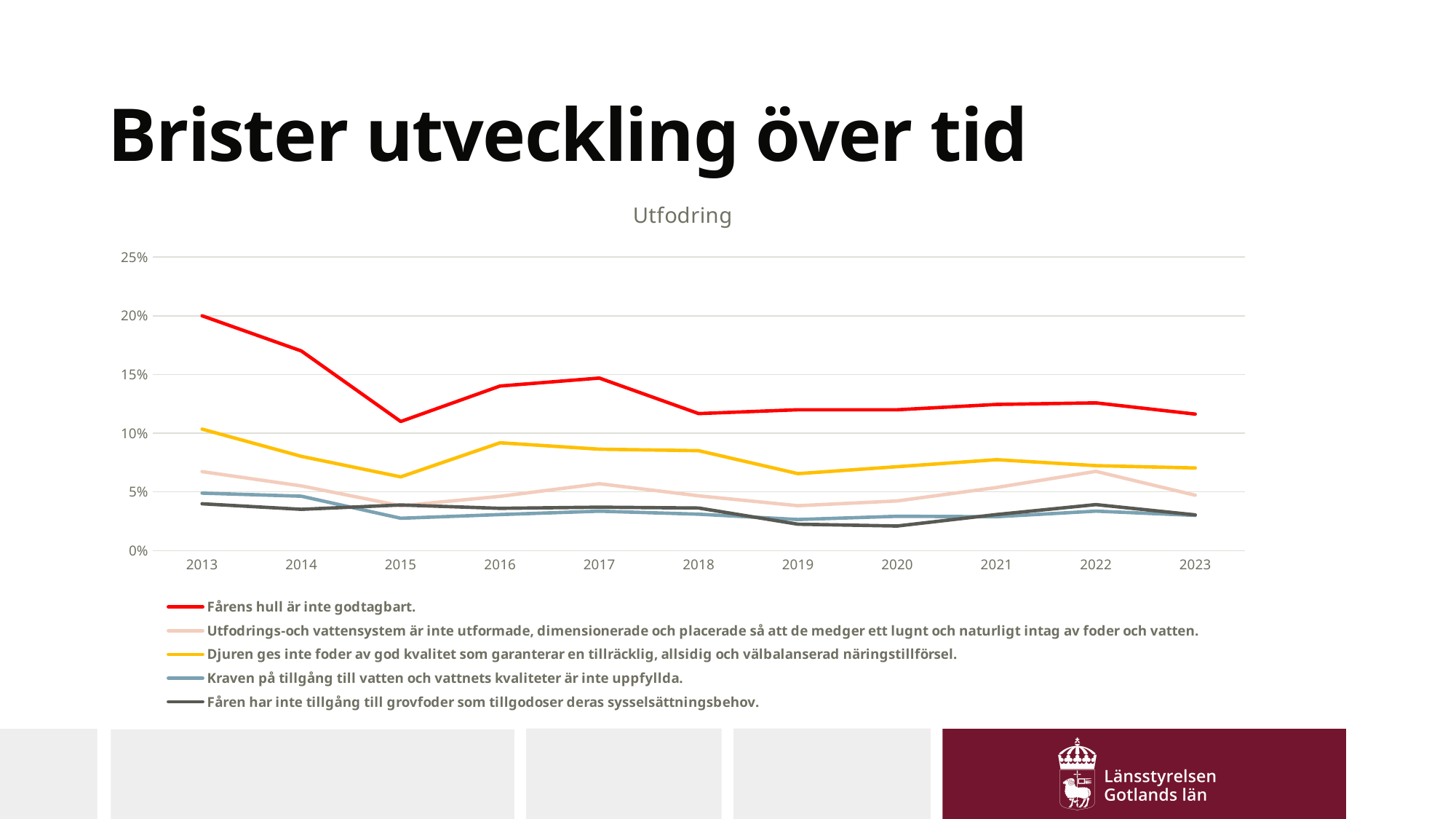
In which year is the value for 'Fårens hull är inte godtagbart.' highest? 2013 In which year is the value for 'Fårens hull är inte godtagbart.' lowest? 2015 What is the title of the chart? Utfodring How many years are shown along the x axis? 11 Is the value for 'Djuren ges inte foder av god kvalitet som garanterar en tillräcklig, allsidig och välbalanserad näringstillförsel.' in 2019 greater or less than 10%? less Is the value for 'Fårens hull är inte godtagbart.' in 2015 greater or less than 15%? less How many series does the legend list? 5 What kind of chart is shown on the slide? line chart Is the value for 'Fårens hull är inte godtagbart.' in 2013 greater or less than 15%? greater In 2023, which is larger: the value for 'Fårens hull är inte godtagbart.' or the value for 'Djuren ges inte foder av god kvalitet som garanterar en tillräcklig, allsidig och välbalanserad näringstillförsel.'? Fårens hull är inte godtagbart. Which series has the highest values across the whole chart? Fårens hull är inte godtagbart. Does the value for 'Fårens hull är inte godtagbart.' rise or fall from 2013 to 2015? fall